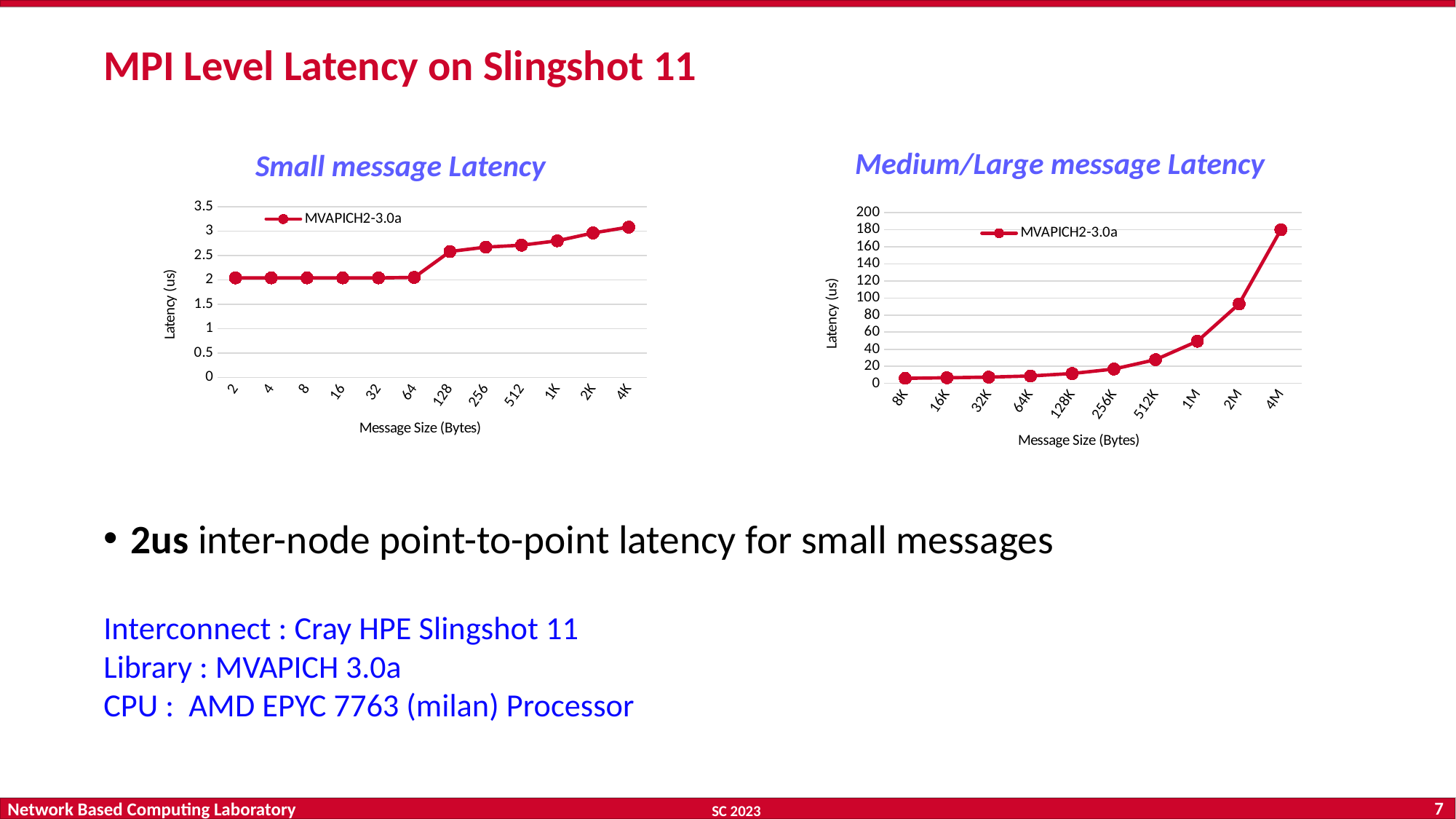
On the Medium/Large message Latency chart, which message size has the highest latency? 4M On the Small message Latency chart, is the latency for 64 bytes greater or less than 2.5? less On the Medium/Large message Latency chart, is the latency for 4M greater or less than 160? greater On the Small message Latency chart, is the latency for 1K greater or less than 3? less How many message sizes are plotted on the Medium/Large message Latency chart? 10 On the Medium/Large message Latency chart, which has the higher latency, 1M or 2M? 2M How many series does the legend of the Medium/Large message Latency chart list? 1 How many message sizes are plotted on the Small message Latency chart? 12 On the Small message Latency chart, which message size has the highest latency? 4K What kind of chart is the Small message Latency chart? line chart What is the name of the series shown in the legend of the Small message Latency chart? MVAPICH2-3.0a